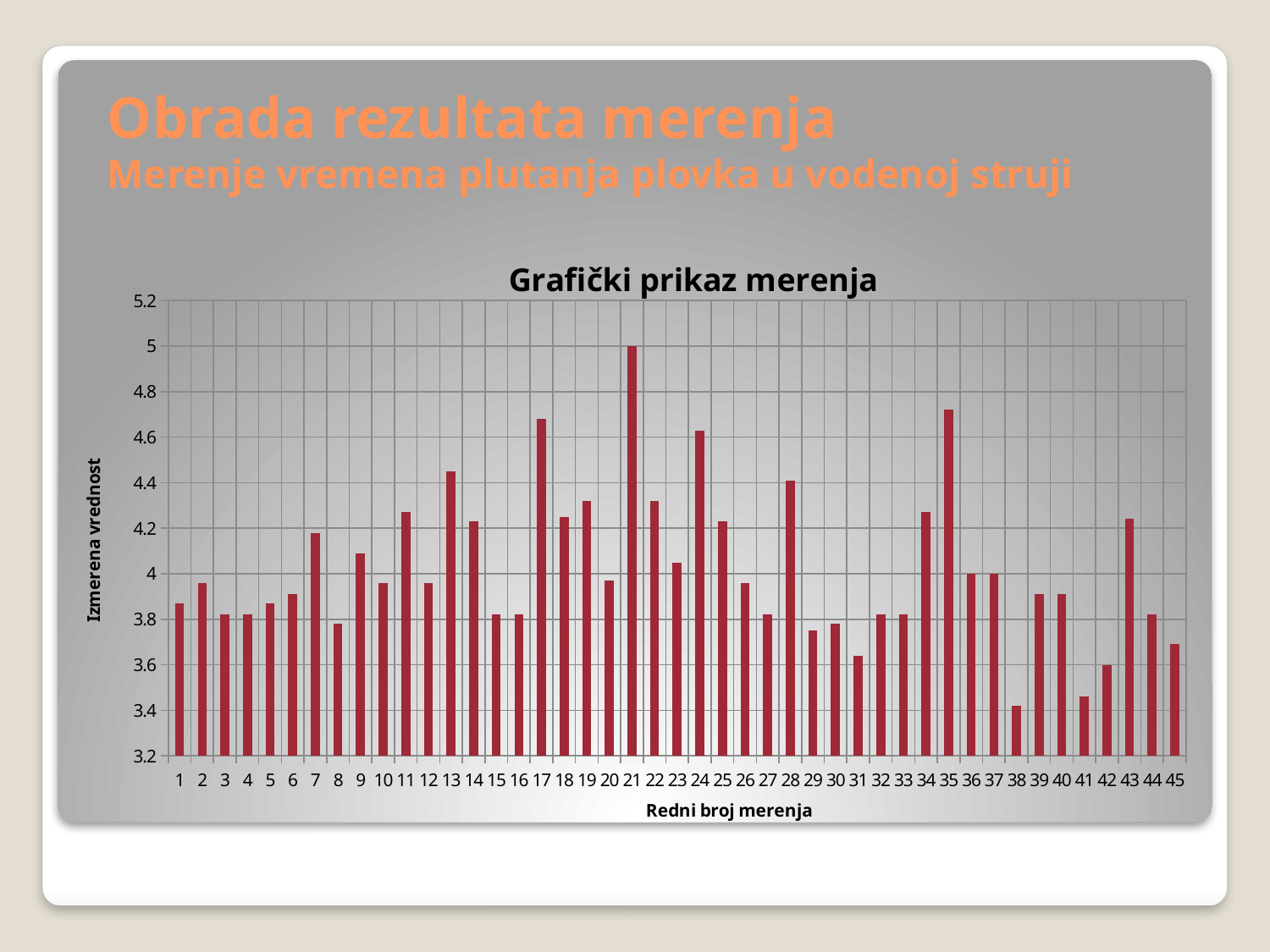
Is the value for measurement 31 greater or less than 3.8? less Is the value for measurement 17 greater or less than 4.6? greater Which has the larger measured value, measurement 7 or measurement 8? measurement 7 What kind of chart is shown on the slide? bar chart Is the value for measurement 38 greater or less than 3.6? less What is the title of the chart? Grafički prikaz merenja Which measurement number has the highest measured value? 21 What is the label of the x axis of the chart? Redni broj merenja Which has the larger measured value, measurement 35 or measurement 34? measurement 35 How many measurements (bars) are plotted in the chart? 45